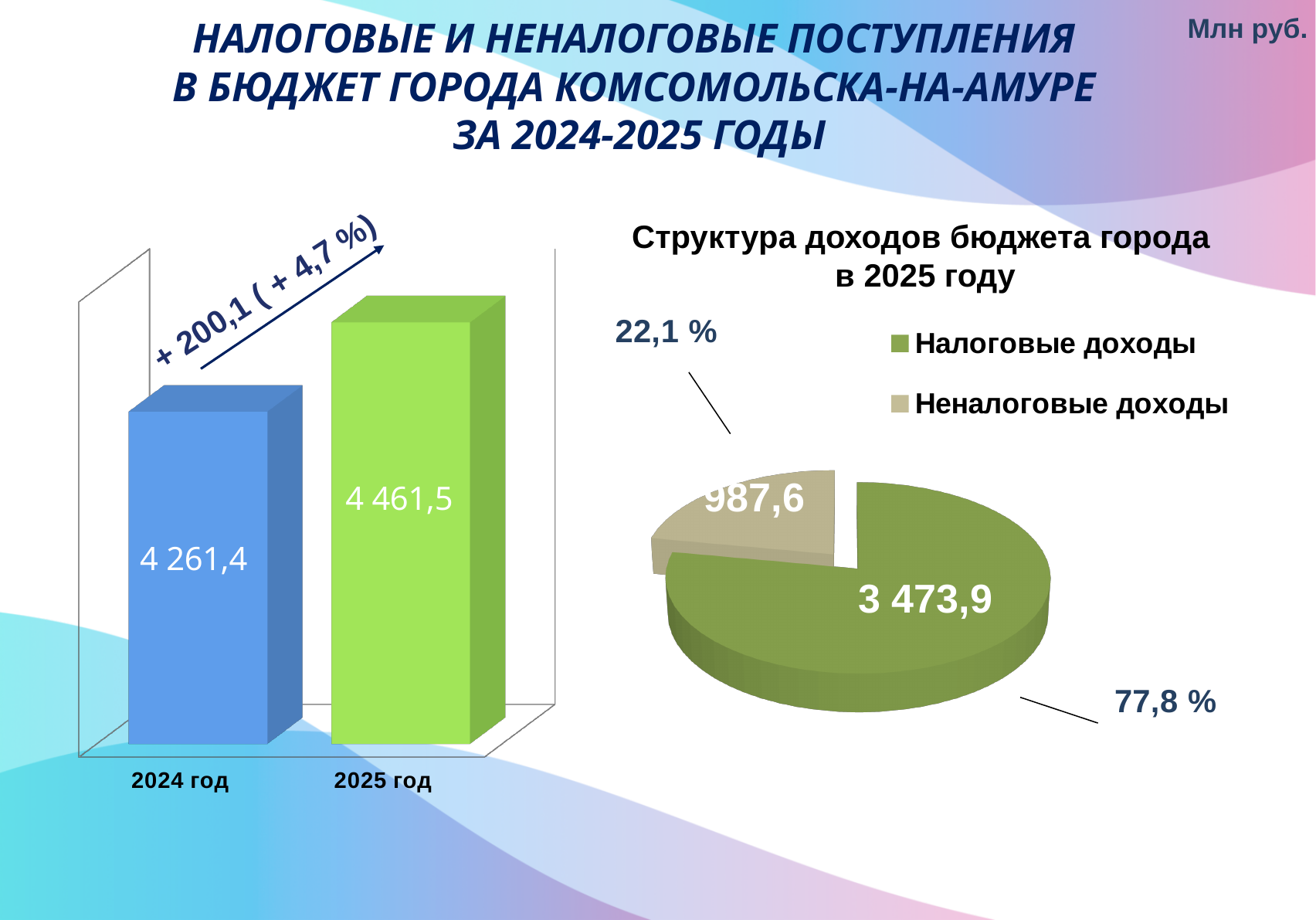
In the pie chart 'Структура доходов бюджета города в 2025 году', what is the value for Налоговые доходы? 3 473,9 In the pie chart 'Структура доходов бюджета города в 2025 году', what share does Налоговые доходы have? 77,8 % In the bar chart on the left, do the values rise or fall from 2024 год to 2025 год? rise In the pie chart 'Структура доходов бюджета города в 2025 году', which slice is larger: Налоговые доходы or Неналоговые доходы? Налоговые доходы In the pie chart 'Структура доходов бюджета города в 2025 году', what share does Неналоговые доходы have? 22,1 % In the pie chart 'Структура доходов бюджета города в 2025 году', what is the value for Неналоговые доходы? 987,6 In the bar chart on the left, what is the value for 2024 год? 4 261,4 In the bar chart on the left, what is the value for 2025 год? 4 461,5 In the bar chart on the left, what is the difference between the 2025 год and 2024 год values? 200,1 What kind of chart is shown on the left side of the slide? bar chart How many entries does the legend of the pie chart 'Структура доходов бюджета города в 2025 году' list? 2 In the bar chart on the left, which year has the higher value? 2025 год